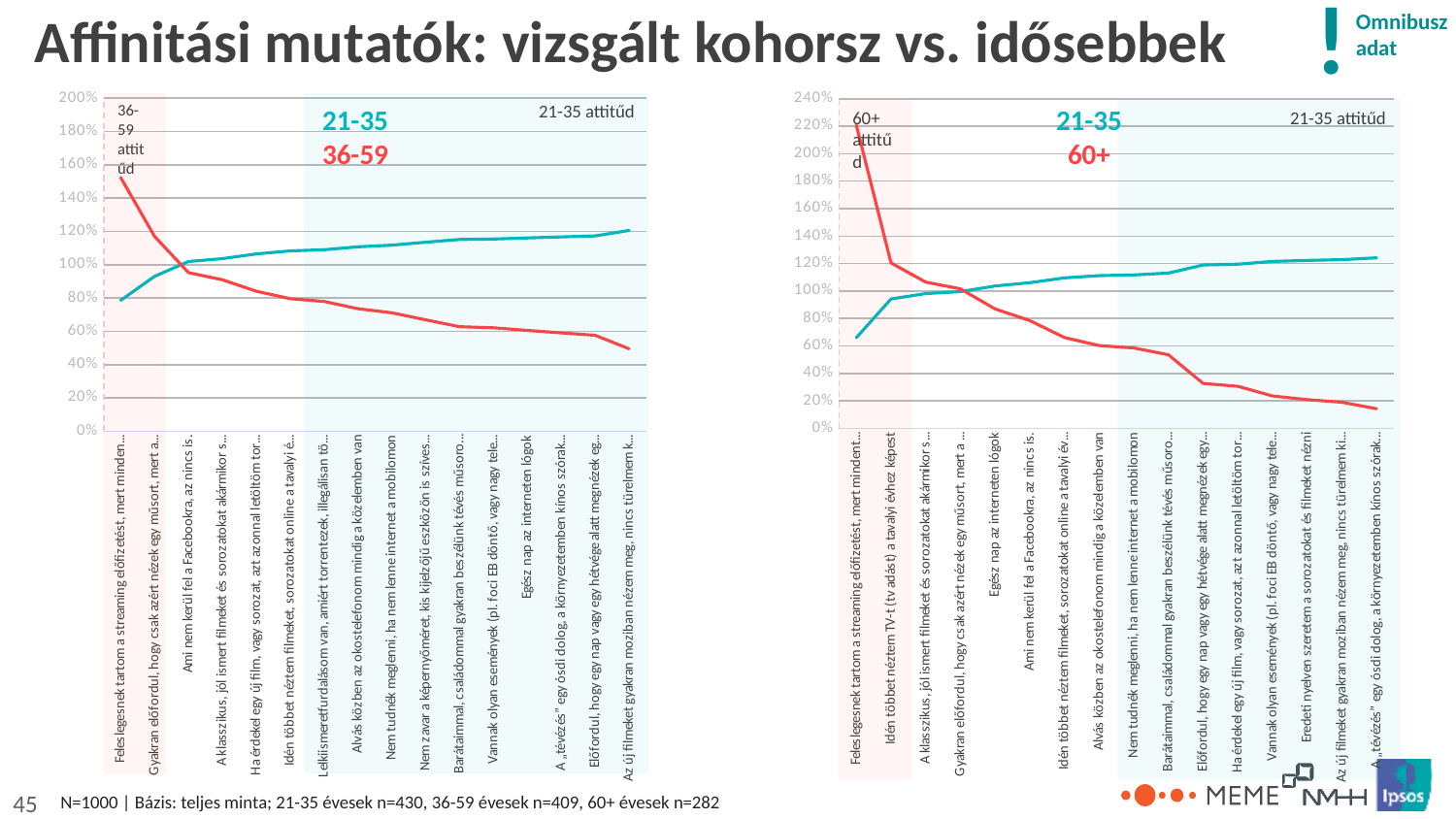
In the left chart, is the 36-59 value for the last category ("Az új filmeket gyakran moziban nézem meg...") greater or less than 60%? less How many series does the left chart show? 2 In the left chart, which series has the higher value for "Egész nap az interneten lógok", 21-35 or 36-59? 21-35 In the left chart, does the 36-59 line rise or fall from left to right? fall In the left chart, does the 21-35 line rise or fall from left to right? rise In the right chart, is the 60+ value for the last category ("A „tévézés” egy ósdi dolog...") greater or less than 20%? less What kind of chart is the left chart on the slide? line chart Which two groups are compared in the right chart? 21-35 and 60+ In the right chart, does the 60+ line rise or fall from left to right? fall In the right chart, is the 60+ value for the first category ("Feleslegesnek tartom a streaming előfizetést...") greater or less than 200%? greater